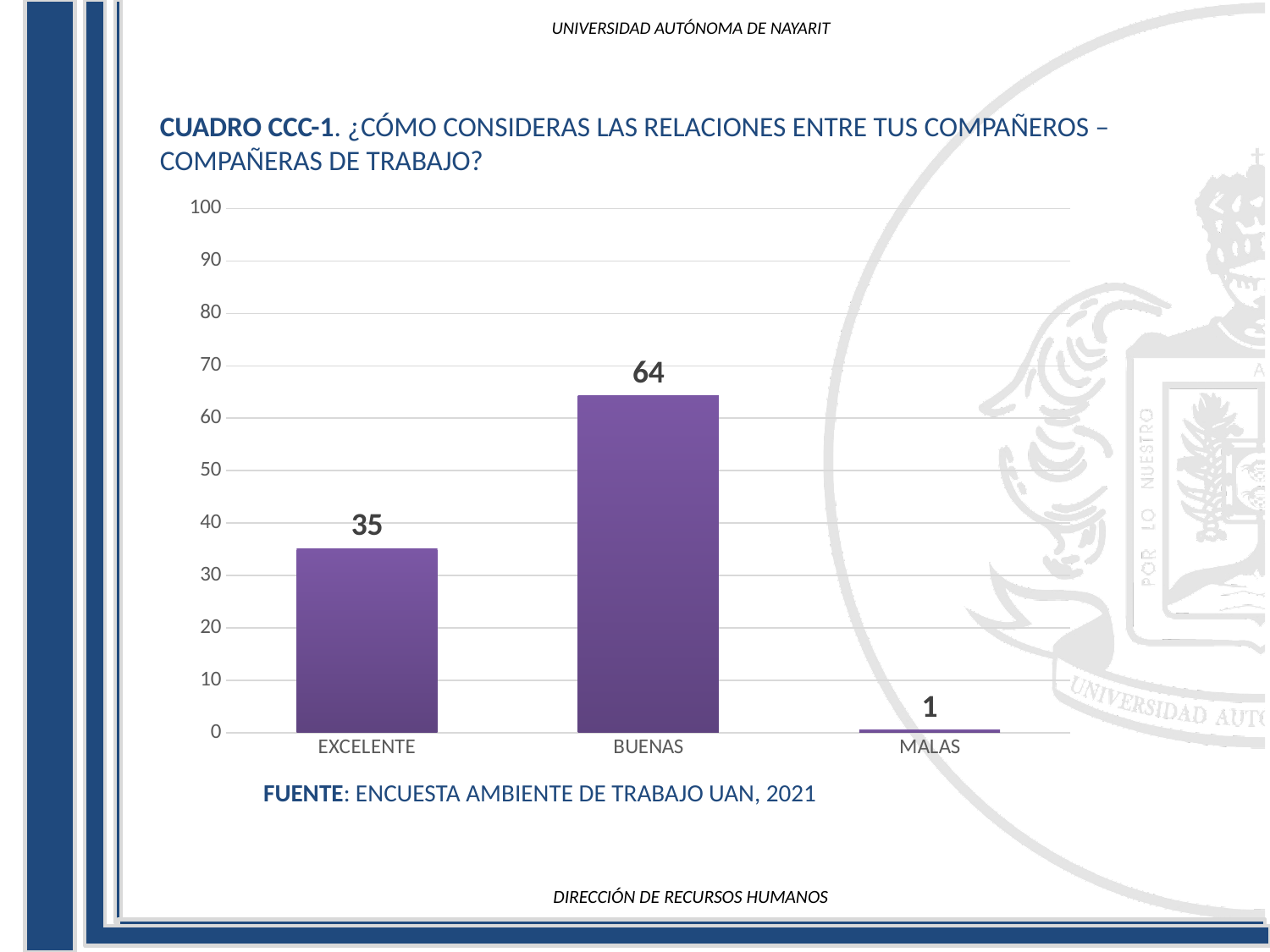
What is the value for BUENAS? 64 Which category has the highest value? BUENAS How many categories are shown on the x axis? 3 Which is larger, the value for EXCELENTE or the value for BUENAS? BUENAS What source is cited below the chart? ENCUESTA AMBIENTE DE TRABAJO UAN, 2021 Is the value for BUENAS greater or less than 50? greater What is the value for EXCELENTE? 35 What is the difference between the values for BUENAS and EXCELENTE? 29 What is the value for MALAS? 1 What kind of chart is shown on the slide? bar chart What is the difference between the values for EXCELENTE and MALAS? 34 Which category has the lowest value? MALAS